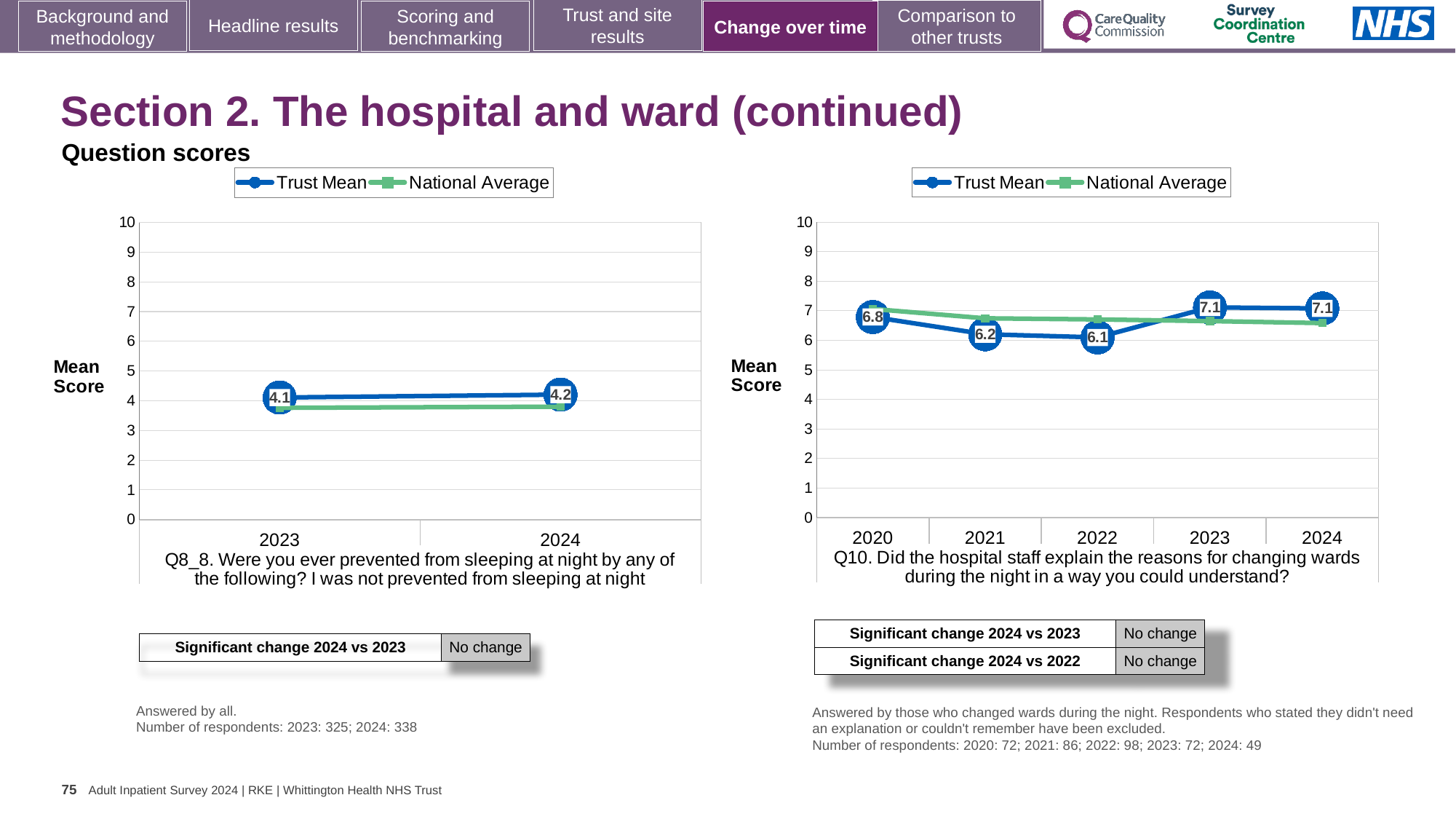
How many series does the legend of the left chart (Q8_8) list? 2 In the right chart (Q10), is the Trust Mean value for 2021 larger or smaller than the value for 2020? smaller In the left chart (Q8_8), is the National Average value for 2023 greater or less than 5? less In the right chart (Q10), does the Trust Mean rise or fall from 2022 to 2023? rise In the right chart (Q10), what is the Trust Mean value for 2022? 6.1 In the left chart (Q8_8), what is the Trust Mean value for 2023? 4.1 In the right chart (Q10), what is the Trust Mean value for 2020? 6.8 What type of chart is the right chart (Q10)? Line chart How many years are shown on the x axis of the right chart (Q10)? 5 In the left chart (Q8_8), what is the Trust Mean value for 2024? 4.2 In the right chart (Q10), what is the difference between the Trust Mean values for 2023 and 2021? 0.9 In the right chart (Q10), which year has the lowest Trust Mean value? 2022